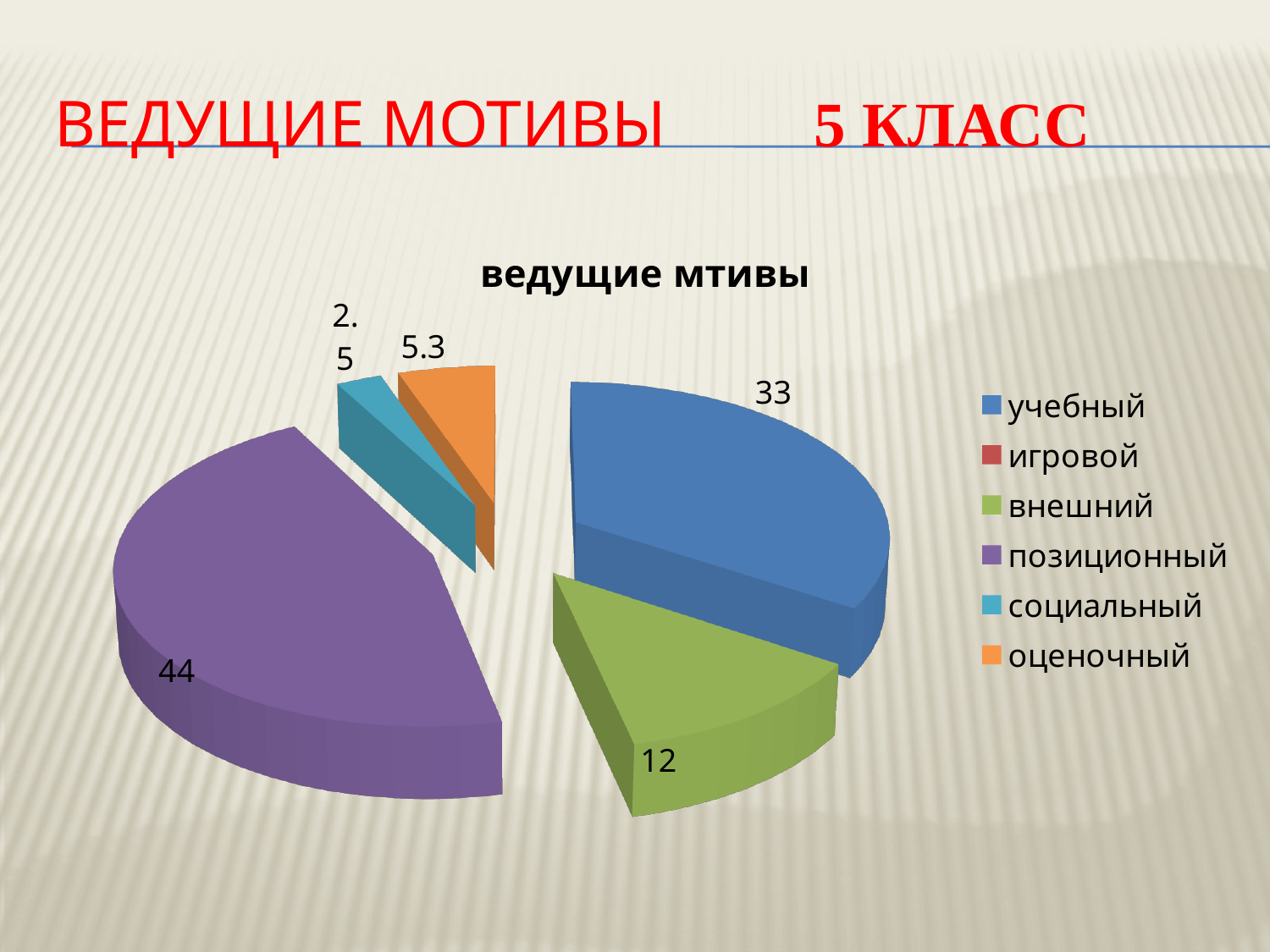
What is the value for позиционный? 44 How many categories does the legend list? 6 What is the value for учебный? 33 Which is larger, the value for оценочный or the value for социальный? оценочный What kind of chart is shown on the slide? pie chart What is the difference between the values for учебный and внешний? 21 What colour is the позиционный slice? purple What is the value for социальный? 2.5 Which category has the largest slice? позиционный What is the value for внешний? 12 What is the difference between the values for позиционный and учебный? 11 What is the value for оценочный? 5.3